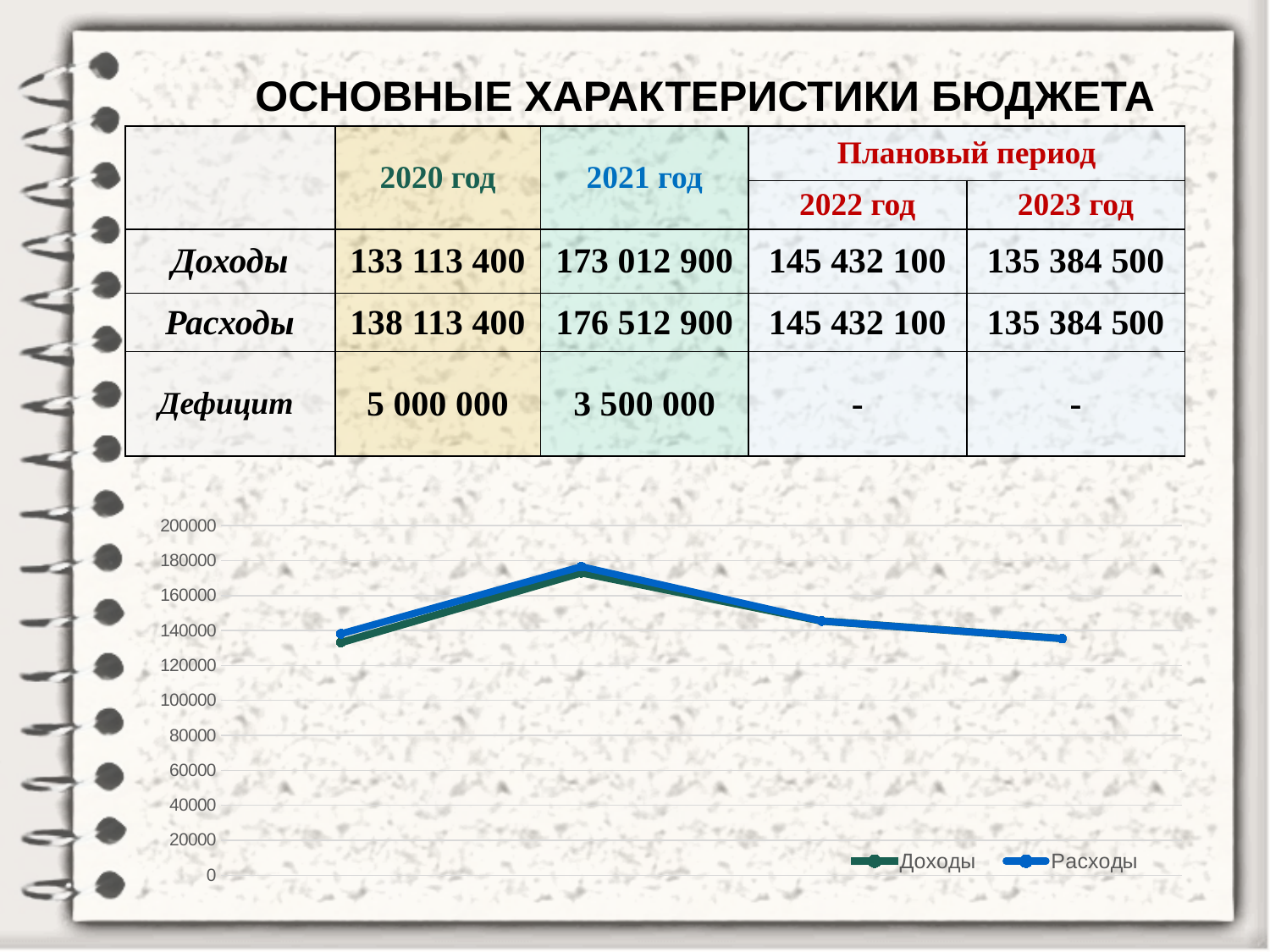
Is the value of the third point of the Доходы line greater or less than 160000? less How many series does the chart legend list? 2 What kind of chart is shown on the slide? line chart How many data points does each line in the chart have? 4 What are the two series named in the chart legend? Доходы and Расходы Is the value of the second point of the Расходы line greater or less than 160000? greater Is the value of the fourth (last) point of the Расходы line greater or less than 140000? less From the second point to the fourth point, do the values of the Расходы line rise or fall? fall At which point along the x axis does the Расходы line reach its highest value? the second point At the first point, which line is higher, Доходы or Расходы? Расходы What is the highest tick value shown on the chart's vertical axis? 200000